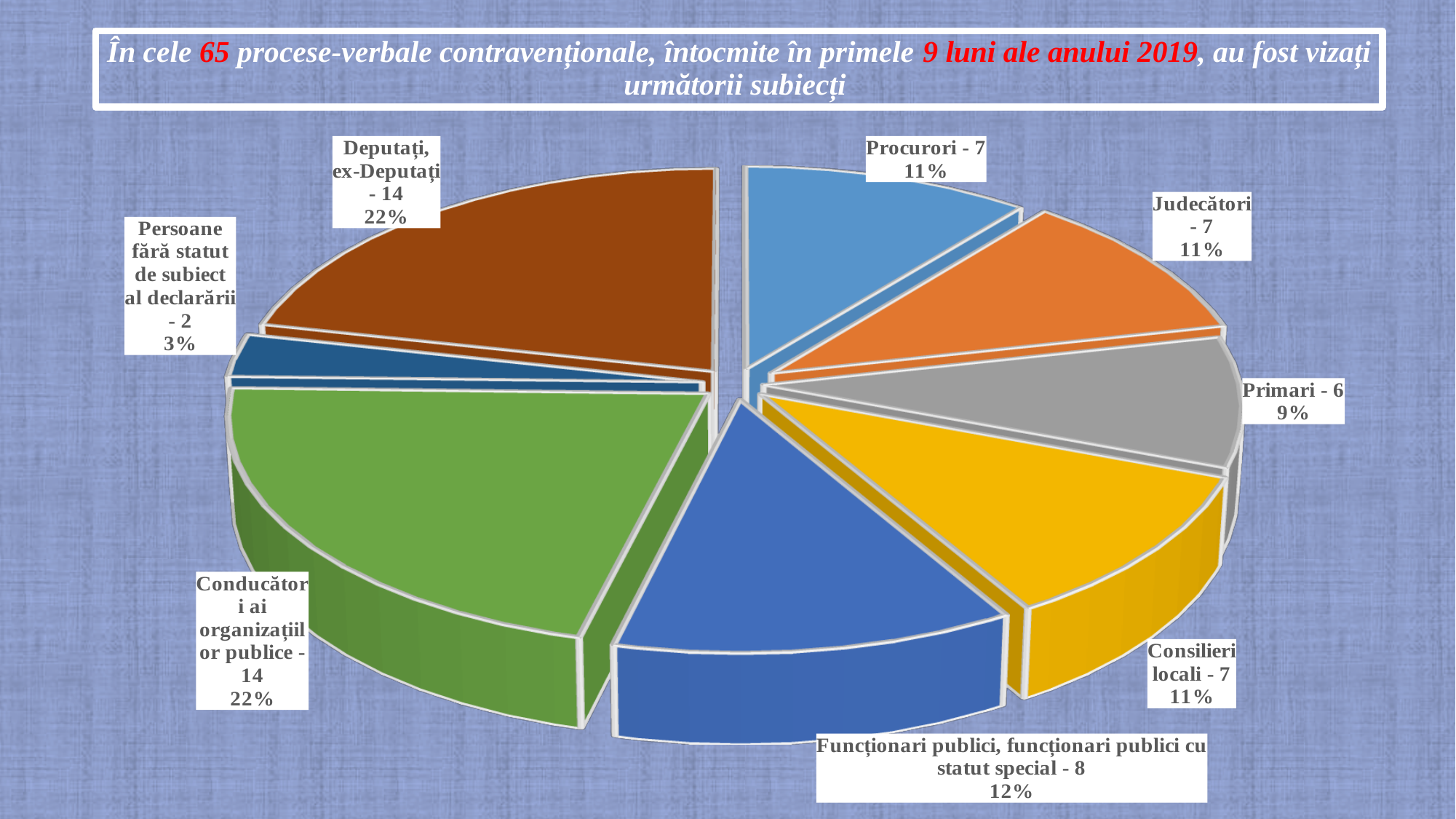
What is the difference between the value for Conducătorii ai organizațiilor publice and the value for Persoane fără statut de subiect al declarării? 12 What percentage share of the pie does Deputați, ex-Deputați represent? 22% Which category has the smallest slice of the pie? Persoane fără statut de subiect al declarării What is the value shown for Primari? 6 What kind of chart is shown on the slide? pie chart According to the slide title, how many procese-verbale contravenționale were drawn up in the first 9 months of 2019? 65 How many categories (slices) does the pie chart have? 8 Which is larger: the value for Funcționari publici, funcționari publici cu statut special or the value for Primari? Funcționari publici, funcționari publici cu statut special What is the difference between the value for Judecători and the value for Primari? 1 What is the value shown for Funcționari publici, funcționari publici cu statut special? 8 How many procese-verbale are attributed to Procurori? 7 What percentage share of the pie does Primari represent? 9%